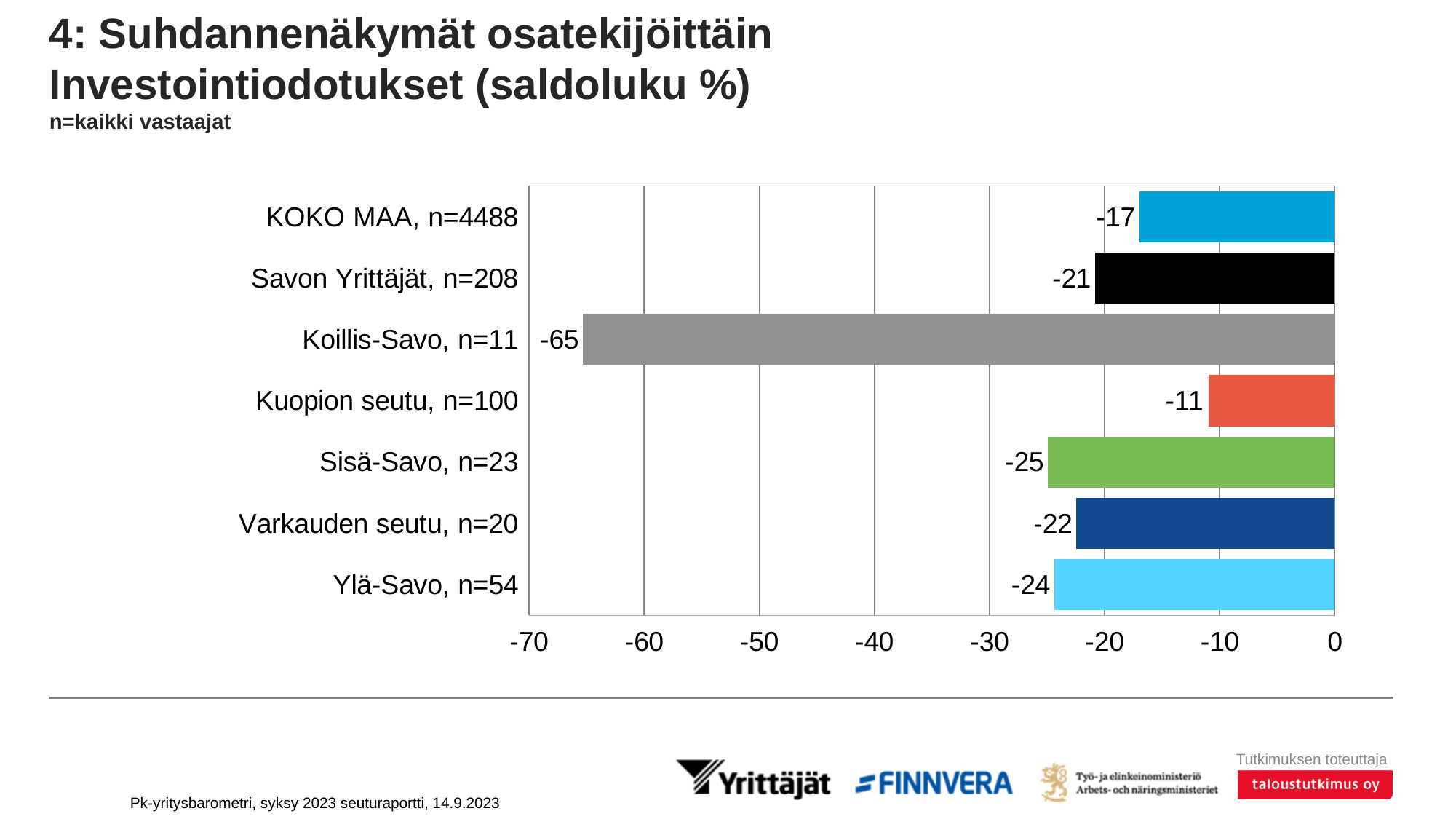
What colour is the bar for Koillis-Savo, n=11? grey Is the value for Koillis-Savo, n=11 greater or less than -60? less What kind of chart is shown on the slide? bar chart What is the value for Koillis-Savo, n=11? -65 What is the value for Ylä-Savo, n=54? -24 Which category has the highest value? Kuopion seutu, n=100 Which has a higher value, Varkauden seutu, n=20 or Ylä-Savo, n=54? Varkauden seutu, n=20 What is the value for KOKO MAA, n=4488? -17 How many categories are shown in the chart? 7 What is the value for Kuopion seutu, n=100? -11 Which category has the lowest value? Koillis-Savo, n=11 What is the difference between the values for Savon Yrittäjät, n=208 and Sisä-Savo, n=23? 4